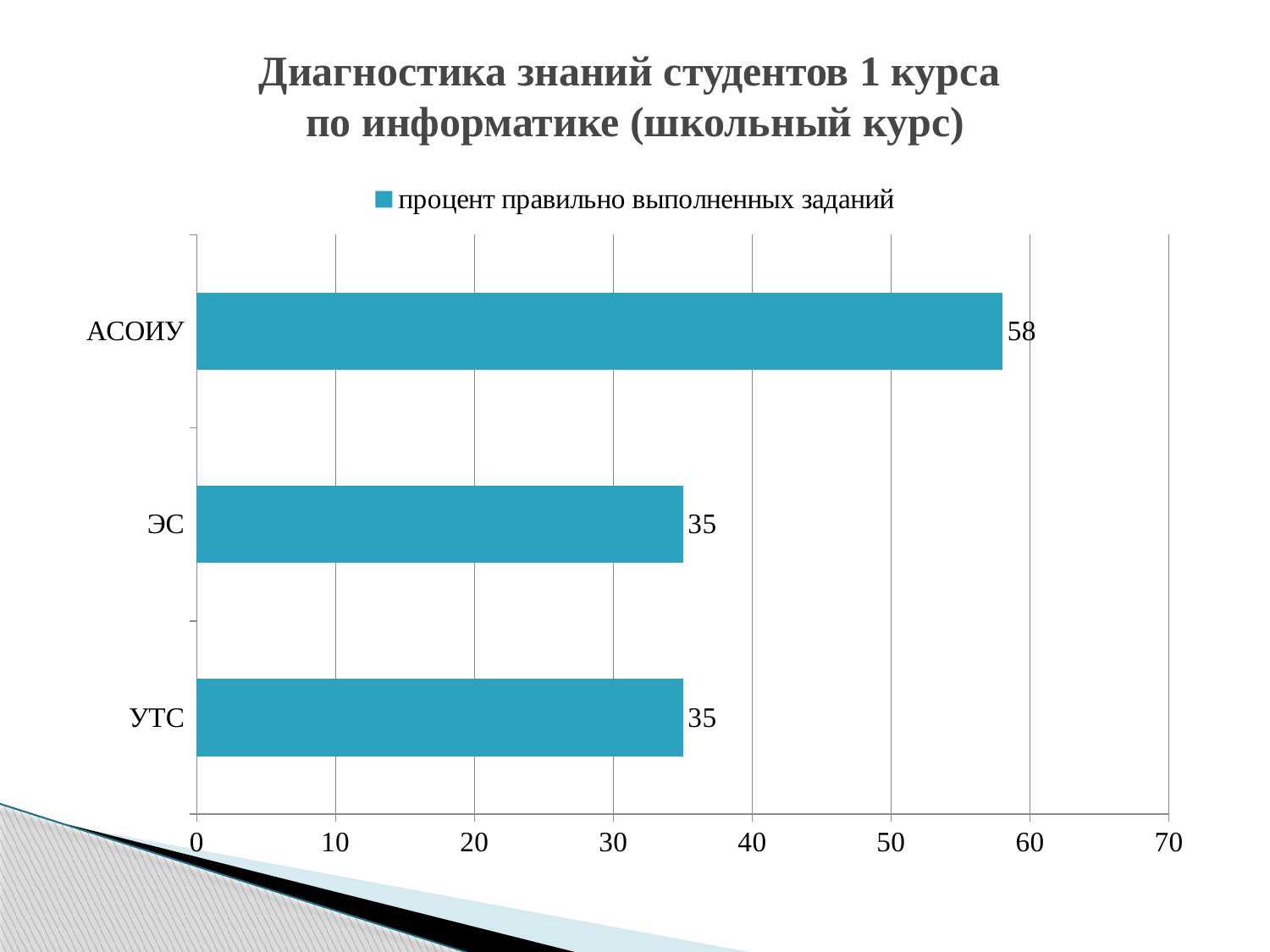
What is the value for АСОИУ? 58 Is the value for АСОИУ greater or less than 50? greater What is the value for УТС? 35 What is the value for ЭС? 35 Which is larger, the value for АСОИУ or the value for УТС? АСОИУ Is the value for ЭС greater or less than 40? less Which category has the highest value? АСОИУ What is the legend entry for the series shown? процент правильно выполненных заданий What is the difference between the values for АСОИУ and ЭС? 23 How many series does the legend list? 1 What kind of chart is shown on the slide? bar chart How many categories are shown in the chart? 3